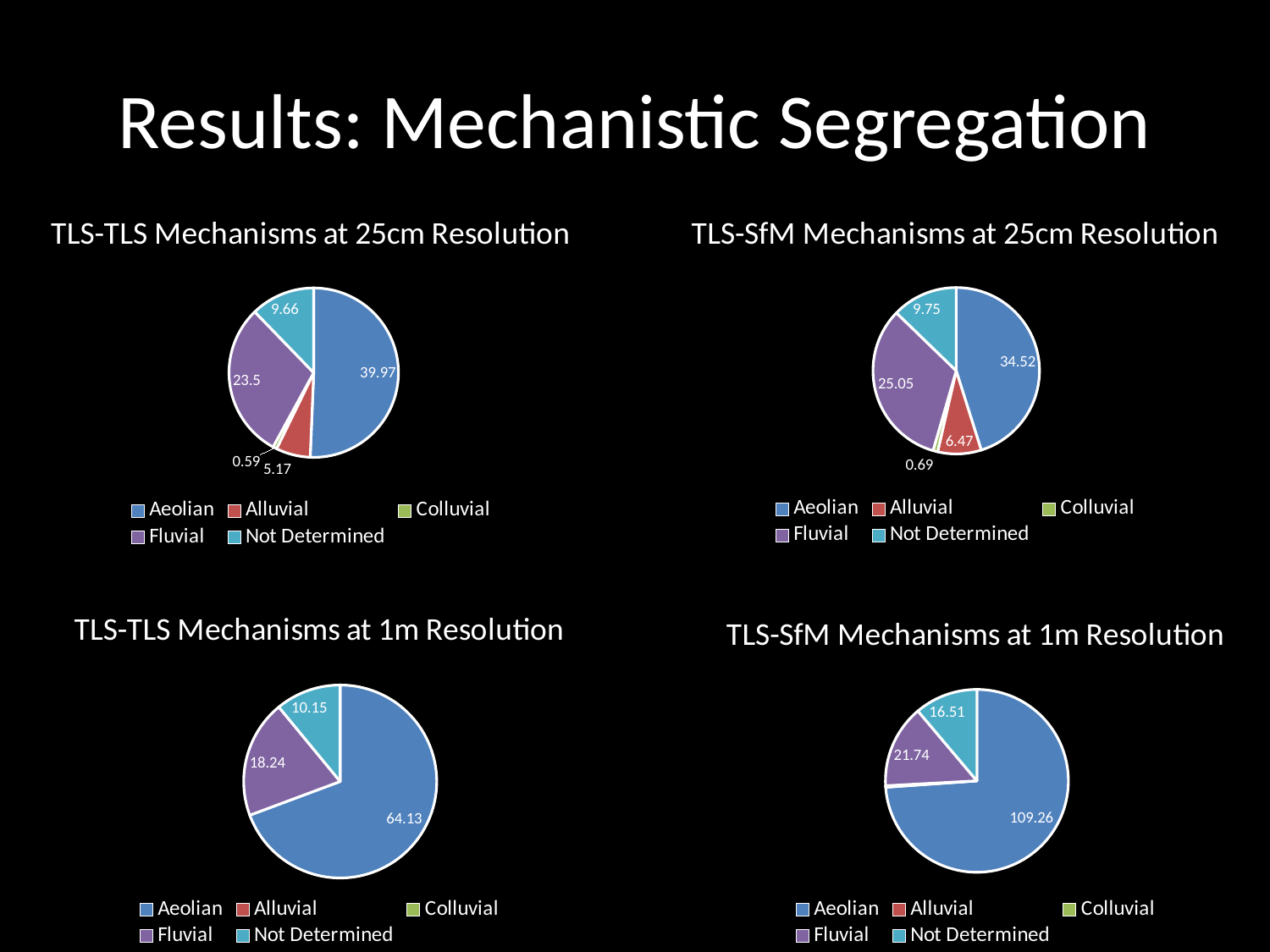
In the TLS-TLS Mechanisms at 1m Resolution chart, what is the value for Fluvial? 18.24 In the TLS-SfM Mechanisms at 25cm Resolution chart, what is the value for Fluvial? 25.05 In the TLS-SfM Mechanisms at 1m Resolution chart, what is the value for Not Determined? 16.51 How many series does the legend of the TLS-SfM Mechanisms at 25cm Resolution chart list? 5 How many charts are shown on the slide? 4 In the TLS-TLS Mechanisms at 25cm Resolution chart, which category has the largest slice? Aeolian What kind of chart is used for TLS-TLS Mechanisms at 1m Resolution? Pie chart In the TLS-TLS Mechanisms at 25cm Resolution chart, what is the difference between the Aeolian and Fluvial values? 16.47 In the TLS-SfM Mechanisms at 1m Resolution chart, what is the difference between the Aeolian and Fluvial values? 87.52 In the TLS-TLS Mechanisms at 25cm Resolution chart, what is the value for Aeolian? 39.97 In the TLS-SfM Mechanisms at 25cm Resolution chart, which category has the smallest slice? Colluvial In the TLS-SfM Mechanisms at 25cm Resolution chart, which is larger, Alluvial or Not Determined? Not Determined